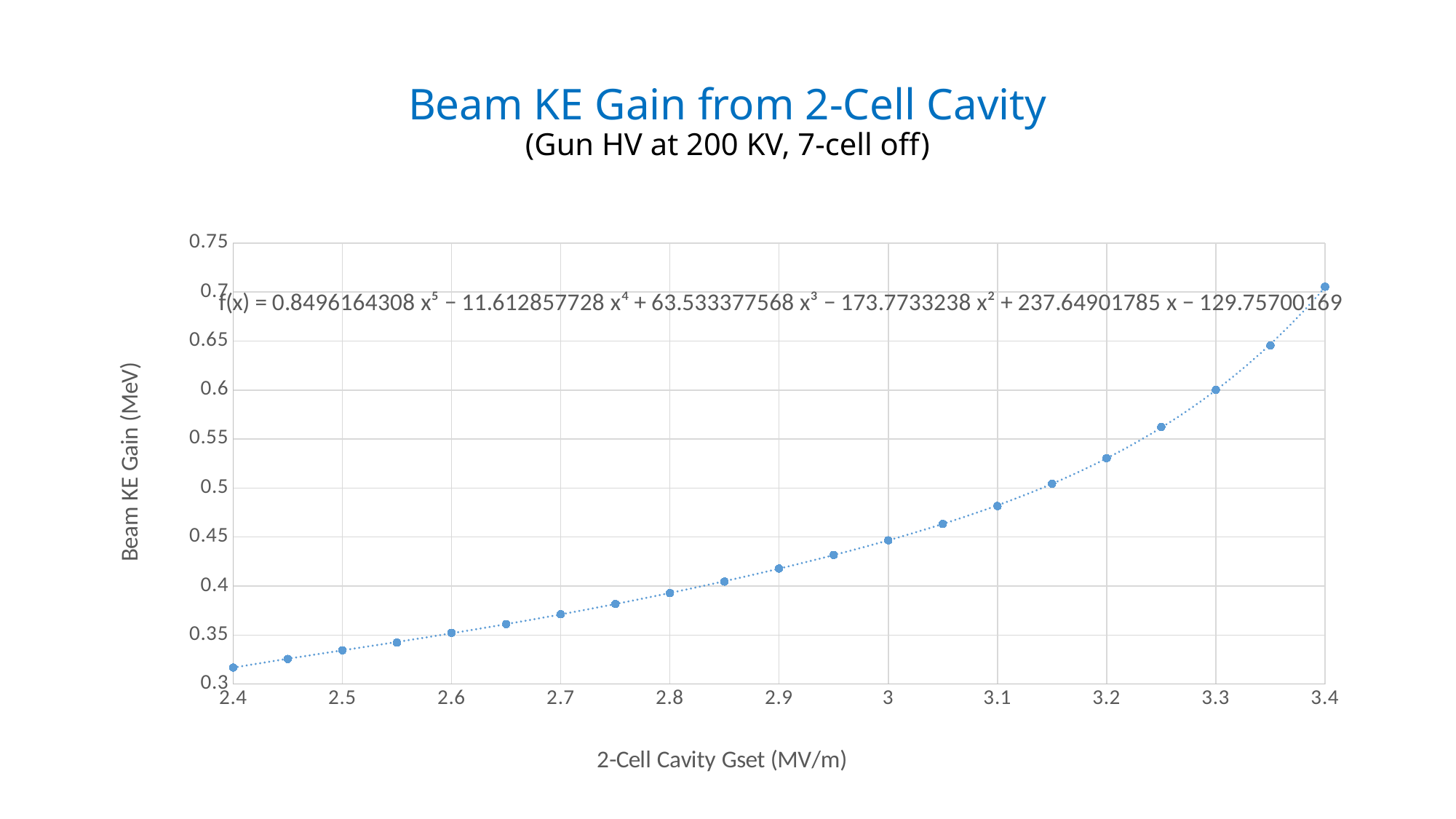
Do the values rise or fall as the 2-Cell Cavity Gset increases along the x axis? Rise Is the Beam KE Gain at a Gset of 3.25 greater or less than 0.55? greater How many data points are plotted on the chart? 21 Is the Beam KE Gain at a Gset of 3.1 greater or less than 0.5? less What is the label of the y axis? Beam KE Gain (MeV) At which 2-Cell Cavity Gset value is the Beam KE Gain highest? 3.4 Is the Beam KE Gain at a Gset of 2.4 greater or less than 0.3? greater Which has the larger Beam KE Gain: a Gset of 2.7 or a Gset of 3.3? 3.3 What is the title of the chart? Beam KE Gain from 2-Cell Cavity What kind of chart is shown on the slide? Scatter chart At which 2-Cell Cavity Gset value is the Beam KE Gain lowest? 2.4